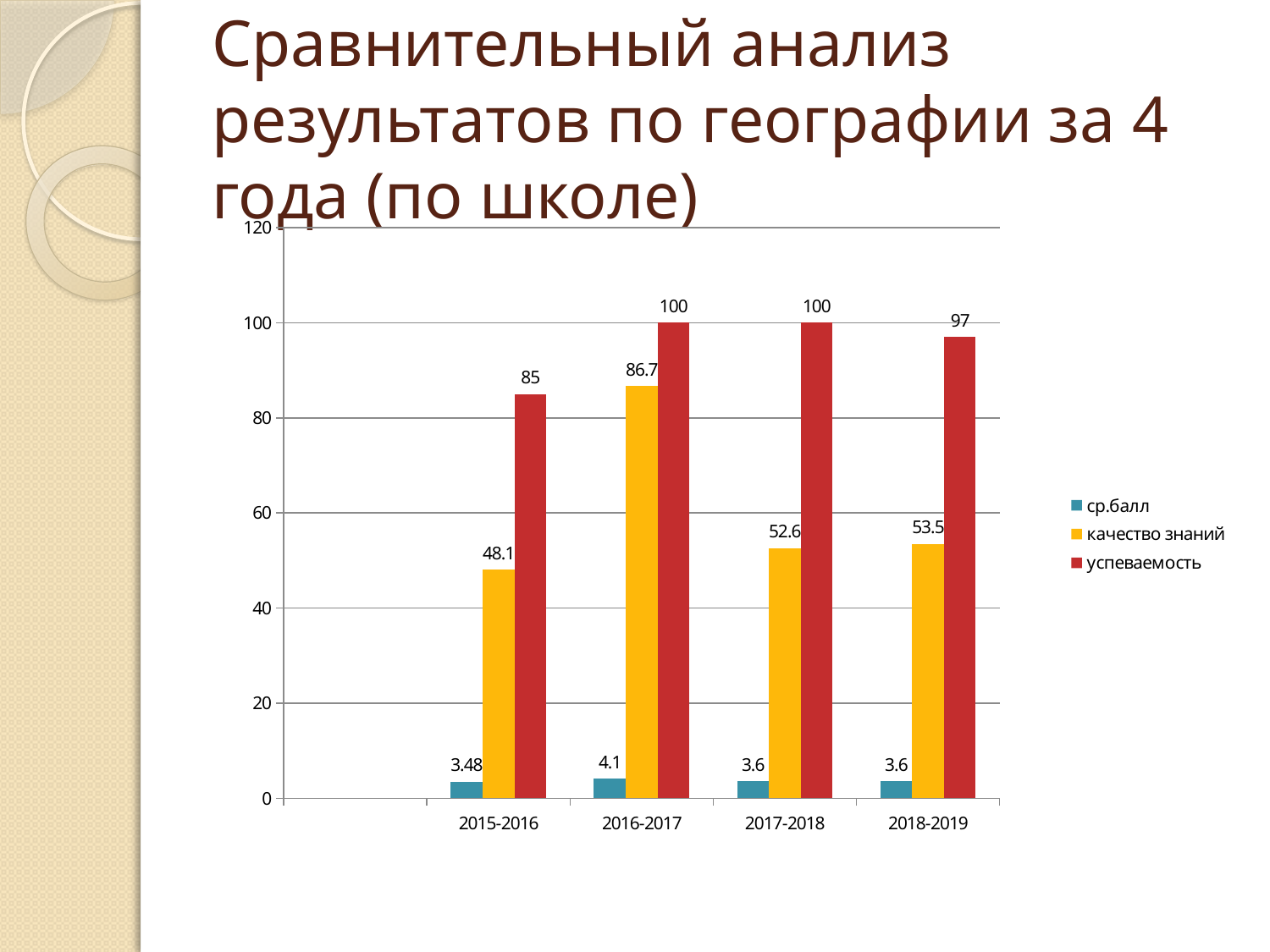
What is the value of успеваемость for 2018-2019? 97 What is the value of качество знаний for 2016-2017? 86.7 How many year categories are shown on the x axis? 4 What is the value of ср.балл for 2015-2016? 3.48 Which is larger: качество знаний in 2017-2018 or in 2018-2019? 2018-2019 In which year is качество знаний the highest? 2016-2017 What kind of chart is shown on the slide? bar chart What colour represents успеваемость in the chart? red Is the value of качество знаний for 2015-2016 greater or less than 60? less What is the difference between успеваемость in 2016-2017 and in 2015-2016? 15 How many series does the legend list? 3 In which year is успеваемость the lowest? 2015-2016